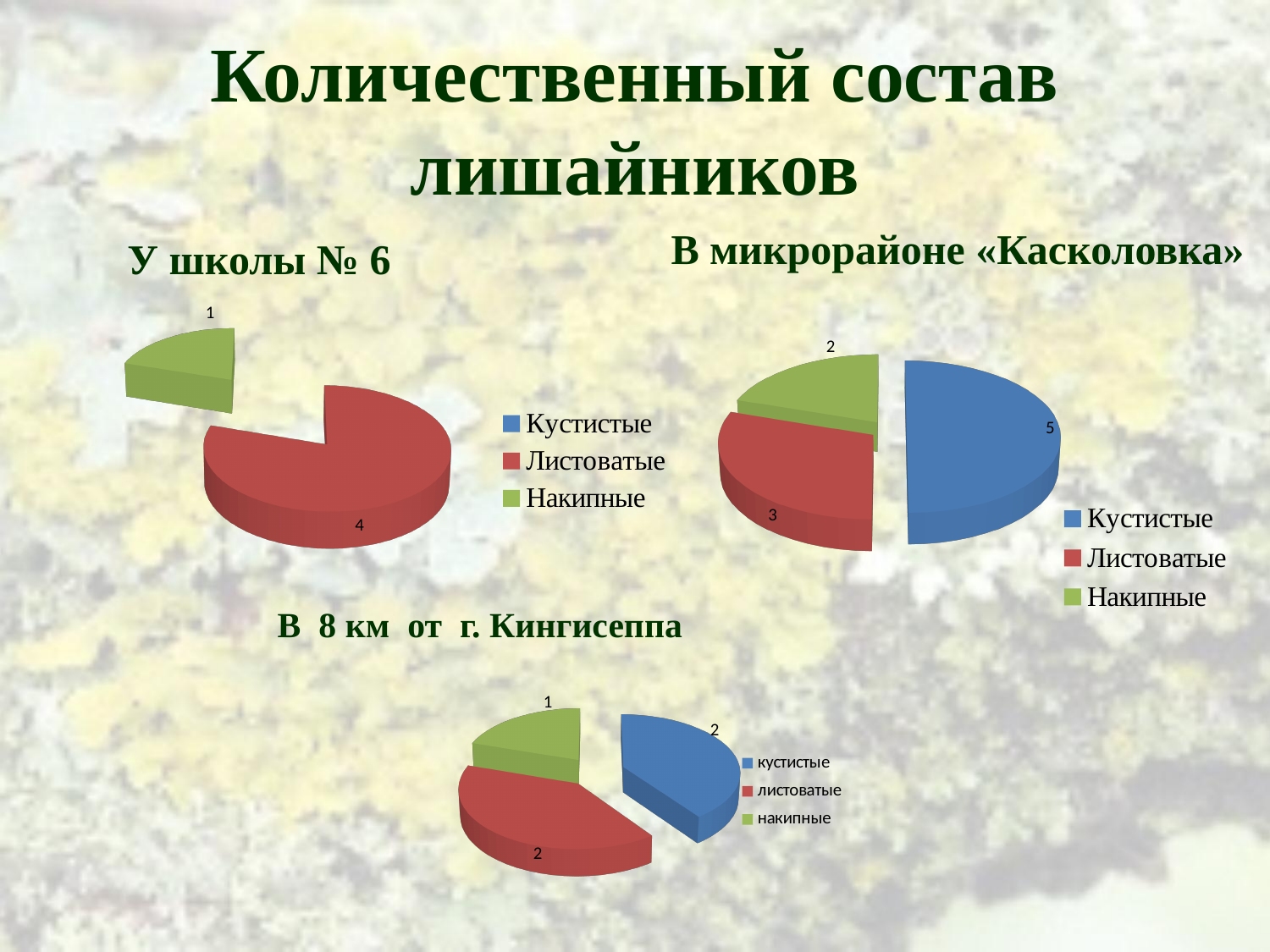
In the chart 'В микрорайоне «Касколовка»', which category has the largest slice? Кустистые In the chart 'В микрорайоне «Касколовка»', what share of the pie does Кустистые represent? 50% In the chart 'В микрорайоне «Касколовка»', what is the value for Листоватые? 3 In the chart 'В микрорайоне «Касколовка»', what is the value for Кустистые? 5 In the chart 'В микрорайоне «Касколовка»', what is the difference between the values for Кустистые and Накипные? 3 In the chart 'В микрорайоне «Касколовка»', which category has the smallest slice? Накипные In the chart 'У школы № 6', what is the value for Накипные? 1 How many entries does the legend of the chart 'В микрорайоне «Касколовка»' list? 3 In the chart 'В 8 км от г. Кингисеппа', what is the value for накипные? 1 What type of chart is used for 'У школы № 6'? Pie chart In the chart 'В 8 км от г. Кингисеппа', which is larger, кустистые or накипные? кустистые In the chart 'У школы № 6', what is the value for Листоватые? 4